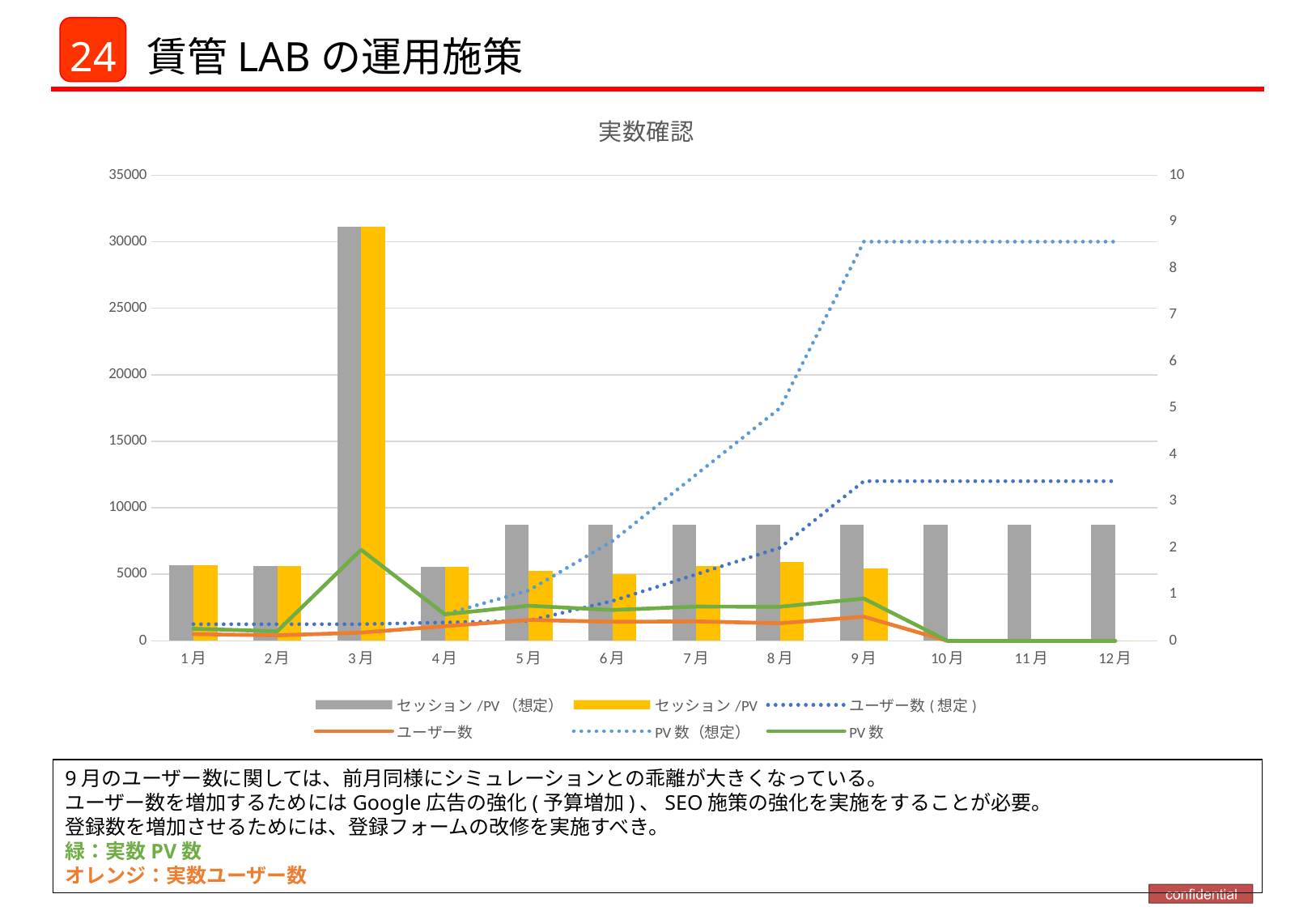
How many months are shown on the x axis of the chart? 12 What is the title of the chart? 実数確認 How many series does the legend list? 6 In which month does the PV数 line reach its peak? 3月 Which is larger, the セッション/PV（想定） bar for 3月 or for 1月? 3月 In which month is the セッション/PV bar the highest? 3月 In which month is the セッション/PV（想定） bar the highest? 3月 Does the PV数（想定） line rise or fall from 1月 to 9月? rise What kind of chart is shown under the title 実数確認? A combination bar and line chart